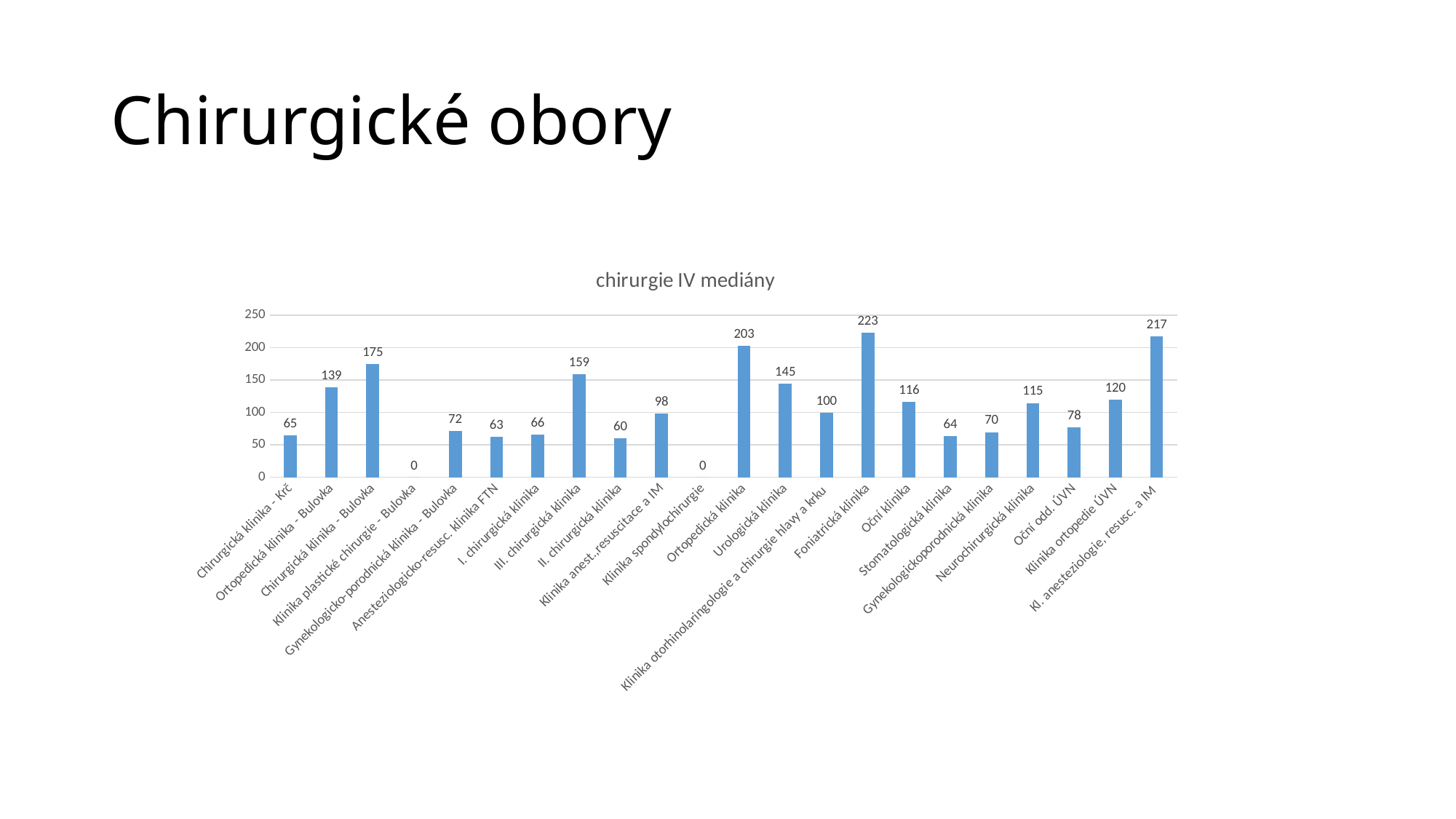
What is the difference between the values for Chirurgická klinika - Bulovka and Chirurgická klinika - Krč? 110 Which category has the highest value? Foniatrická klinika What is the difference between the values for Kl. anesteziologie, resusc. a IM and Ortopedická klinika? 14 Which is larger, the value for III. chirurgická klinika or the value for Oční klinika? III. chirurgická klinika What is the title of the chart? chirurgie IV mediány What is the value for Klinika ortopedie ÚVN? 120 What is the value for Urologická klinika? 145 What is the value for Foniatrická klinika? 223 How many categories have a value of 0? 2 What is the value for Ortopedická klinika - Bulovka? 139 What kind of chart is shown on the slide? Bar chart How many categories are shown on the x axis? 22